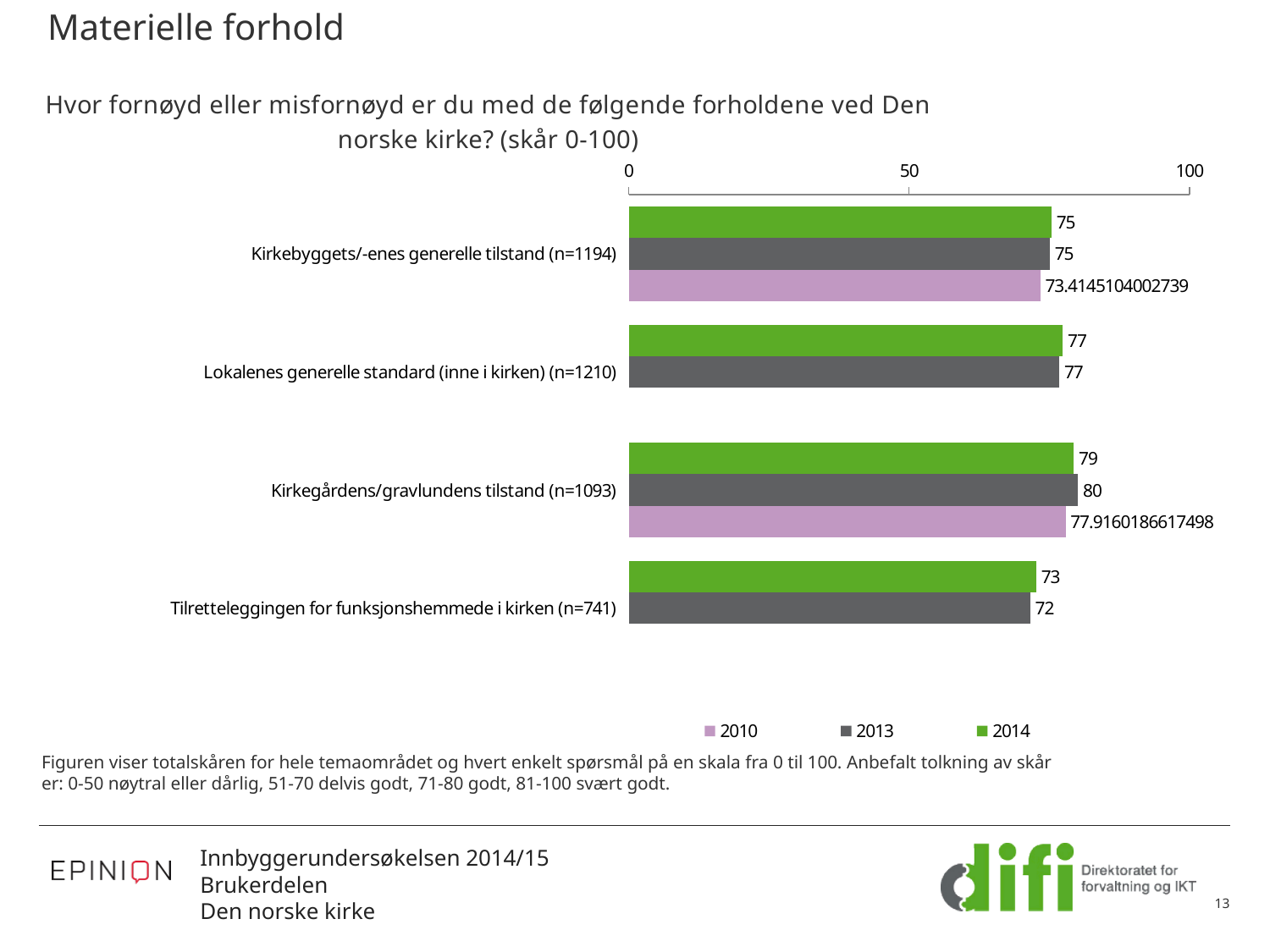
How many categories are shown on the chart? 4 Which category has the lowest 2014 value? Tilretteleggingen for funksjonshemmede i kirken (n=741) What is the 2014 value for Kirkegårdens/gravlundens tilstand (n=1093)? 79 Which category has the highest 2013 value? Kirkegårdens/gravlundens tilstand (n=1093) How many series does the legend list? 3 Is the 2013 value for Kirkebyggets/-enes generelle tilstand (n=1194) greater or less than 50? greater For Kirkegårdens/gravlundens tilstand (n=1093), which is larger: the 2013 value or the 2014 value? 2013 What kind of chart is shown on the slide? bar chart What is the 2013 value for Tilretteleggingen for funksjonshemmede i kirken (n=741)? 72 What is the 2014 value for Lokalenes generelle standard (inne i kirken) (n=1210)? 77 What is the 2010 value for Kirkebyggets/-enes generelle tilstand (n=1194)? 73.4145104002739 What is the difference between the 2014 values for Kirkegårdens/gravlundens tilstand (n=1093) and Tilretteleggingen for funksjonshemmede i kirken (n=741)? 6